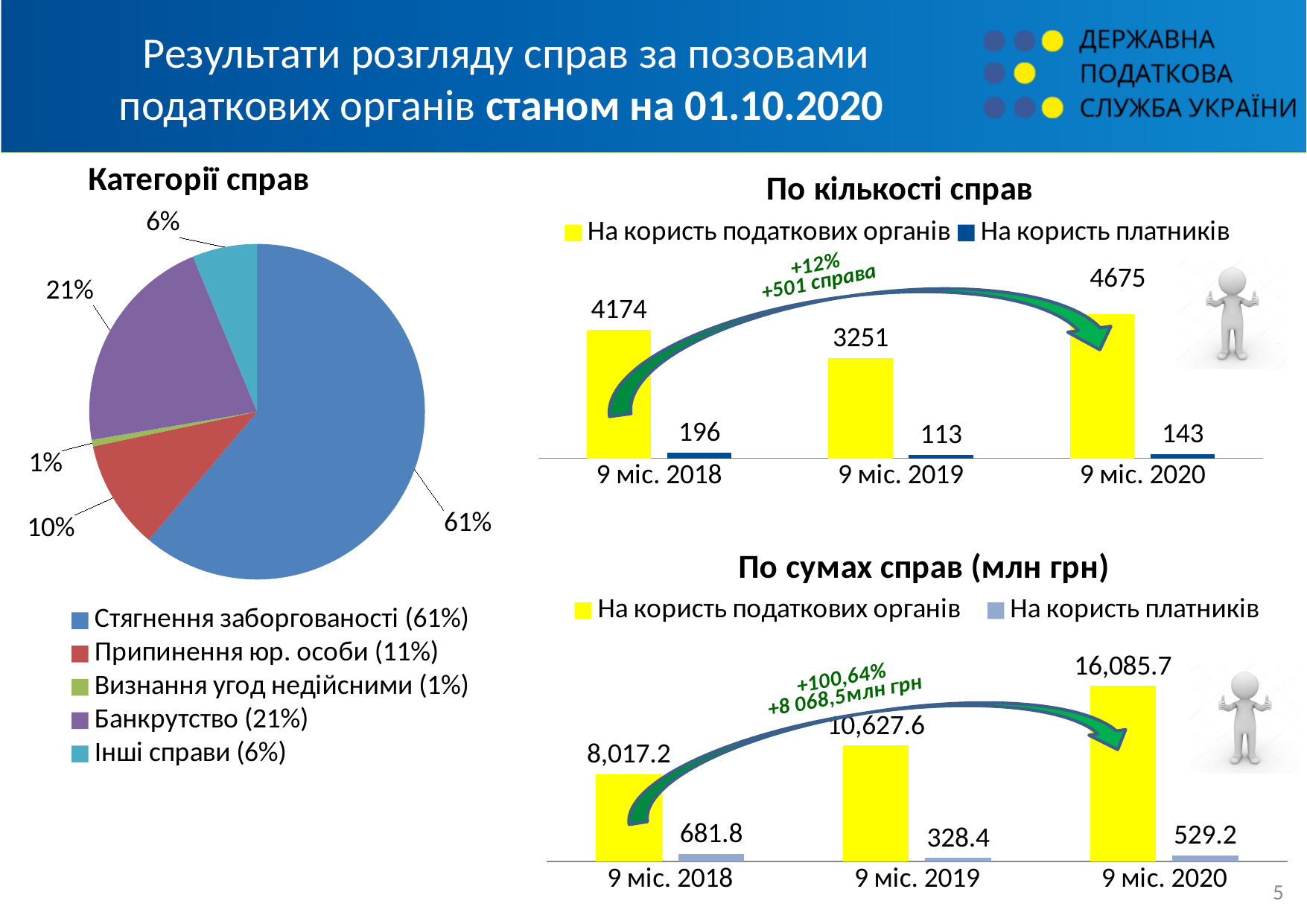
What kind of chart is 'Категорії справ'? pie chart In the chart 'По сумах справ (млн грн)', does the value for 'На користь податкових органів' rise or fall from 9 міс. 2018 to 9 міс. 2020? rise In the chart 'По сумах справ (млн грн)', which is larger: 'На користь платників' in 9 міс. 2018 or in 9 міс. 2019? 9 міс. 2018 In the chart 'По кількості справ', what is the value for 'На користь податкових органів' in 9 міс. 2020? 4675 In the chart 'По кількості справ', how many series does the legend list? 2 In the chart 'По кількості справ', which period has the lowest value for 'На користь податкових органів'? 9 міс. 2019 In the chart 'По кількості справ', what is the difference between the 'На користь податкових органів' values for 9 міс. 2020 and 9 міс. 2018? 501 In the chart 'По кількості справ', what is the value for 'На користь платників' in 9 міс. 2019? 113 In the chart 'По сумах справ (млн грн)', what is the value for 'На користь податкових органів' in 9 міс. 2019? 10,627.6 In the chart 'По сумах справ (млн грн)', which period has the highest value for 'На користь податкових органів'? 9 міс. 2020 In the pie chart 'Категорії справ', what share does 'Банкрутство' have? 21% In the chart 'По сумах справ (млн грн)', what is the value for 'На користь платників' in 9 міс. 2020? 529.2